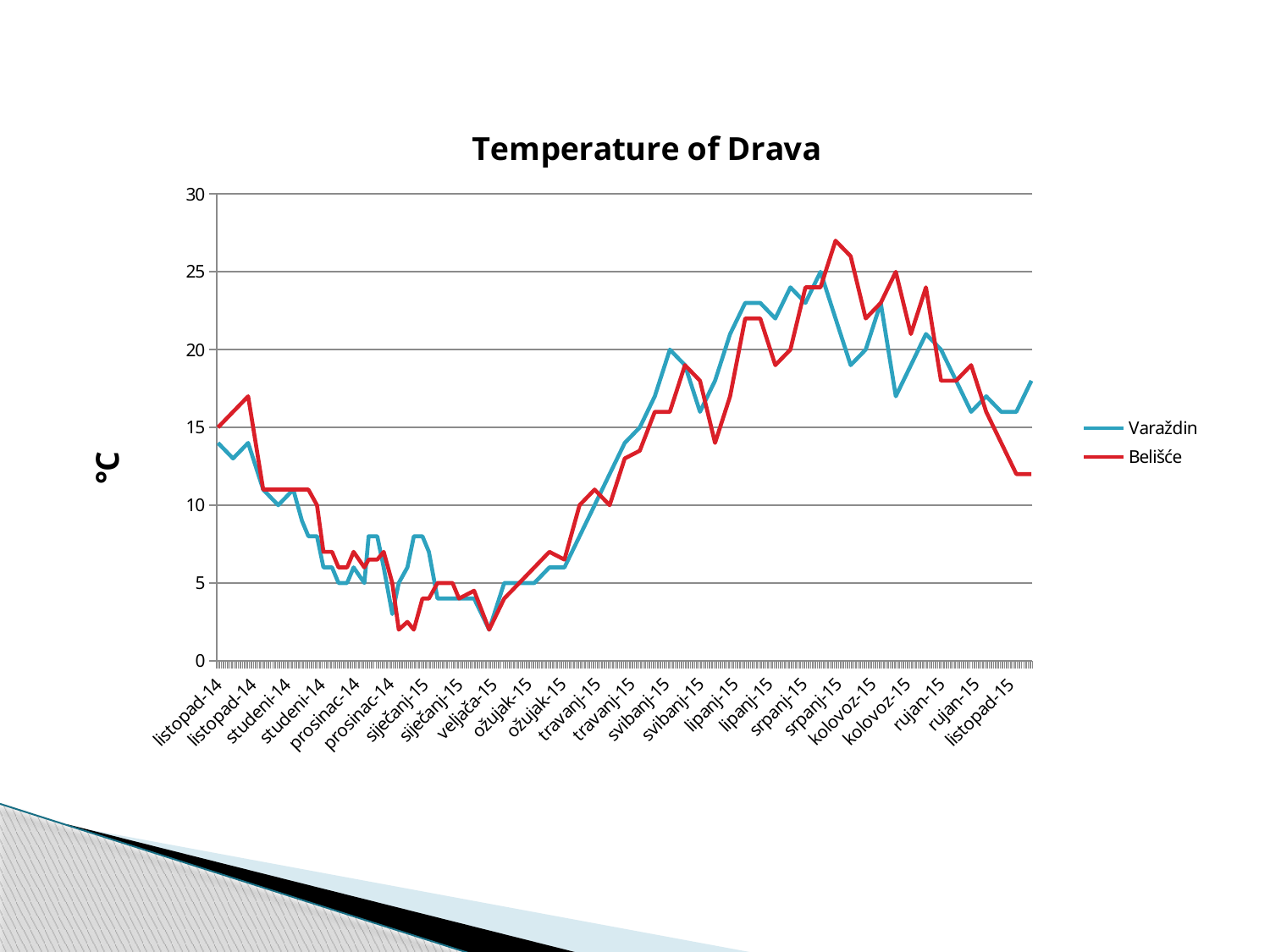
What kind of chart is shown on the slide? line chart Which series reaches the highest temperature anywhere on the chart? Belišće Do the temperatures rise or fall from veljača-15 to srpanj-15? rise Is the lowest value of the Belišće series greater or less than 5? less Is the value for Belišće at the last point (listopad-15) greater or less than 15? less At the last point on the x axis (listopad-15), which series has the higher value, Varaždin or Belišće? Varaždin What are the two series named in the legend? Varaždin and Belišće Is the highest value of the Belišće series greater or less than 25? greater Do the temperatures rise or fall from listopad-14 to siječanj-15? fall How many series does the legend list? 2 What is the title of the chart? Temperature of Drava